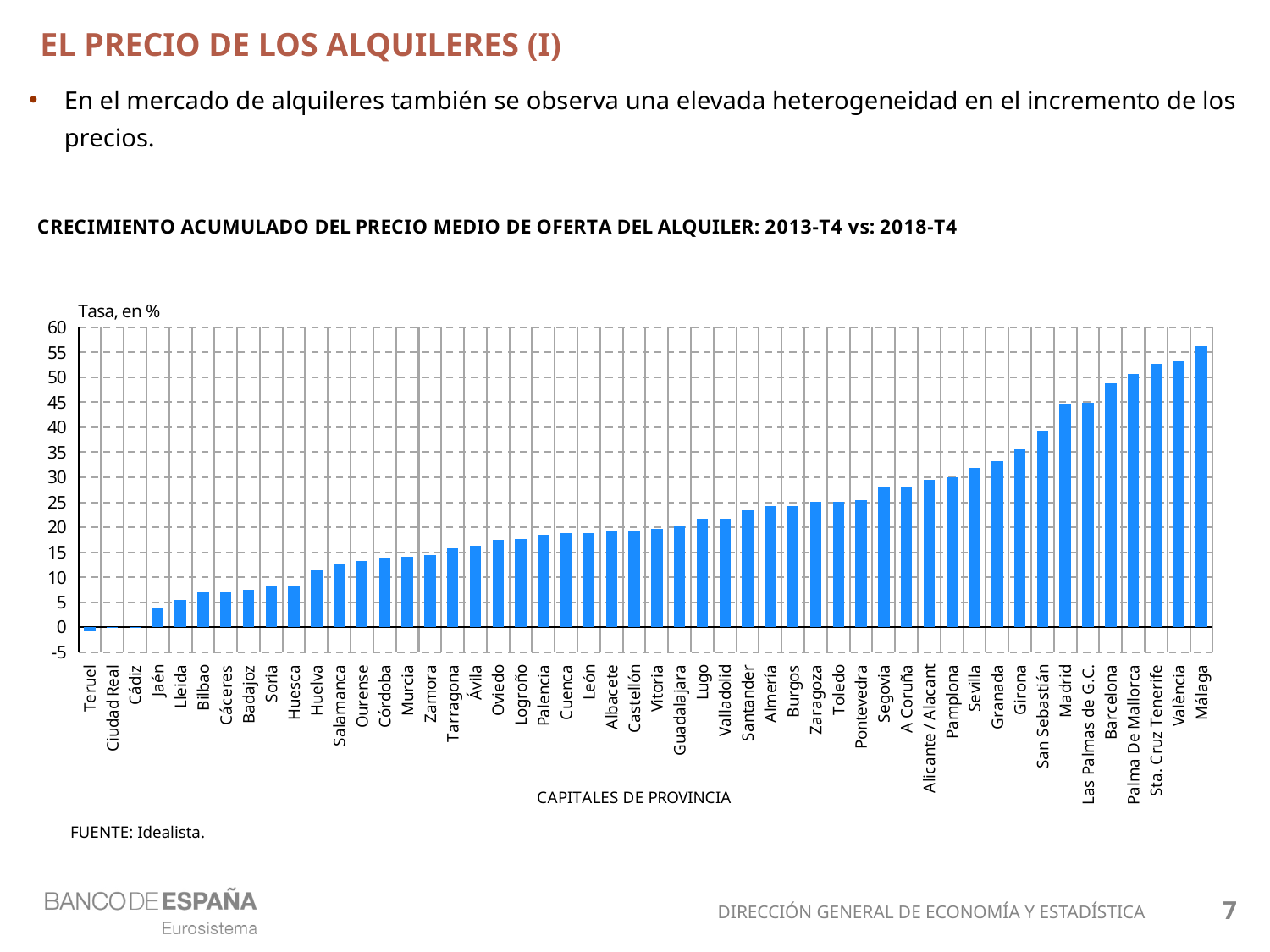
What unit label is shown above the y axis of the chart? Tasa, en % Which provincial capital has the highest accumulated rental price growth in the chart? Málaga Which has a larger value, Madrid or Sevilla? Madrid Is the value for Málaga greater or less than 50? greater Which provincial capital has the lowest value in the chart? Teruel Is the value for Madrid greater or less than 40? greater How many provincial capitals are listed on the x axis of the chart? 50 Is the value for Jaén greater or less than 5? less What kind of chart is shown on the slide? bar chart Do the values rise or fall moving from left to right along the x axis? rise